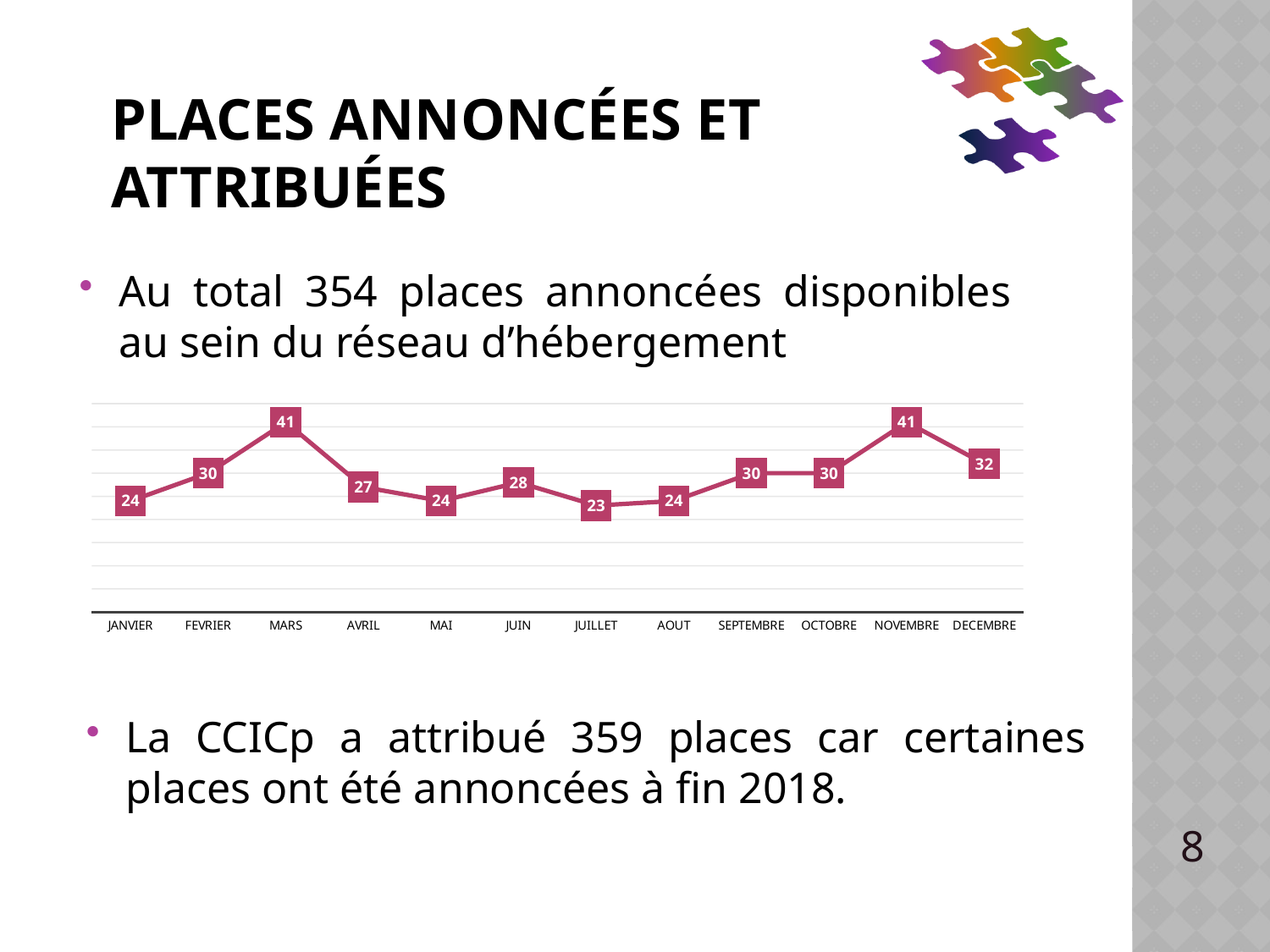
What is the highest value shown on the chart? 41 What is the value for DECEMBRE? 32 Which month has the lowest value? JUILLET What is the difference between the values for DECEMBRE and JANVIER? 8 Which is larger, the value for FEVRIER or the value for JUIN? FEVRIER What is the difference between the values for MARS and AVRIL? 14 What is the value for MARS? 41 Does the value rise or fall from OCTOBRE to NOVEMBRE? Rise What kind of chart is shown on the slide? Line chart What is the value for JUILLET? 23 What is the value for SEPTEMBRE? 30 How many months are plotted on the chart? 12